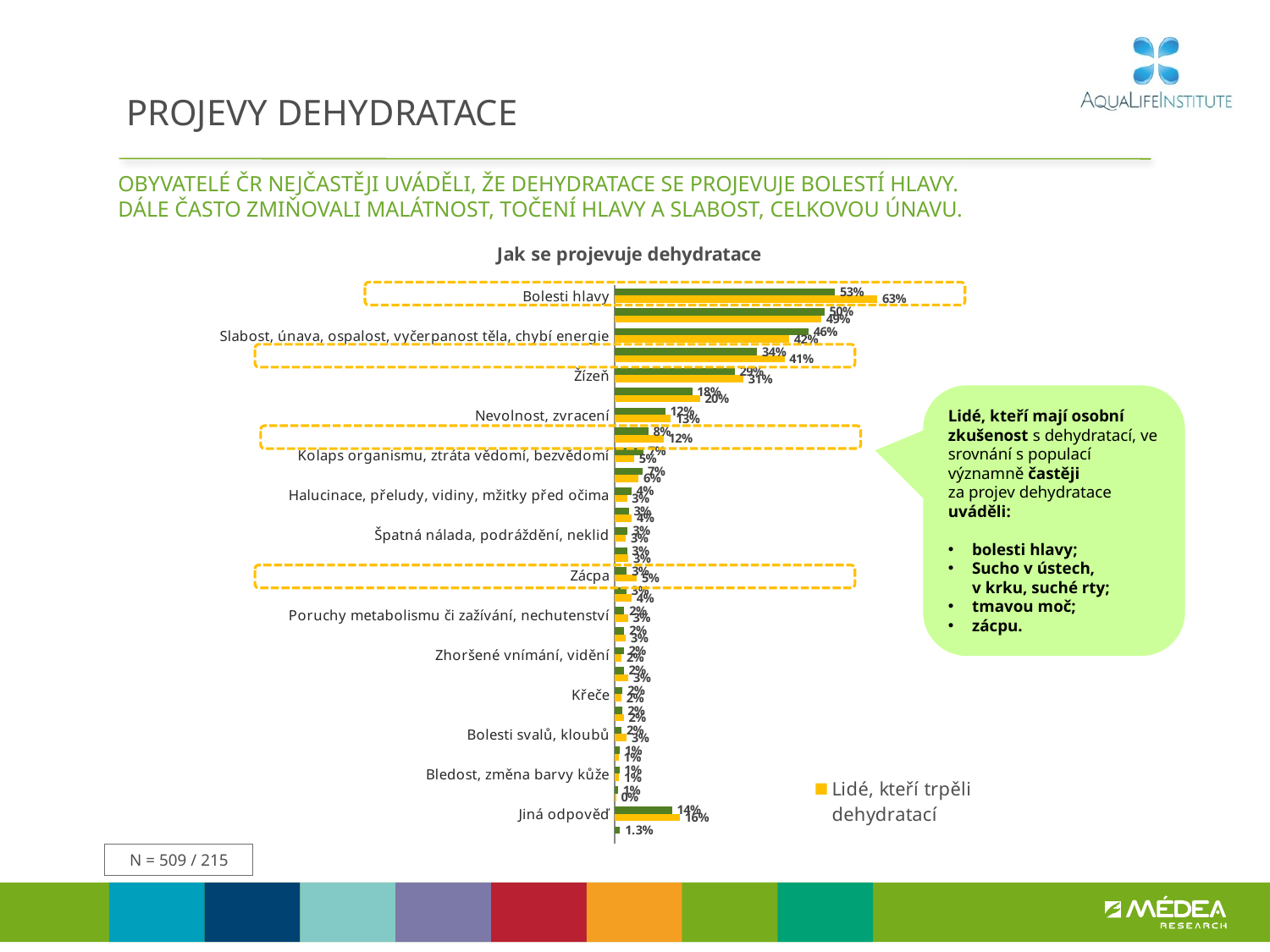
What is the value of the yellow bar (Lidé, kteří trpěli dehydratací) for Jiná odpověď? 16% For Slabost, únava, ospalost, vyčerpanost těla, chybí energie, which bar is larger: the green bar or the yellow bar? the green bar What is the difference between the yellow bar (63%) and the green bar (53%) for Bolesti hlavy? 10 percentage points Which category has the highest values in the chart? Bolesti hlavy What is the value of the yellow bar (Lidé, kteří trpěli dehydratací) for Nevolnost, zvracení? 13% What series name is shown in the chart legend? Lidé, kteří trpěli dehydratací What is the title of the chart? Jak se projevuje dehydratace What is the value of the yellow bar (Lidé, kteří trpěli dehydratací) for Žízeň? 31% For the yellow series (Lidé, kteří trpěli dehydratací), which is larger: Bolesti hlavy or Žízeň? Bolesti hlavy What is the value of the yellow bar (Lidé, kteří trpěli dehydratací) for Bolesti hlavy? 63% What kind of chart is shown on the slide? bar chart What is the value of the green bar for Bolesti hlavy? 53%